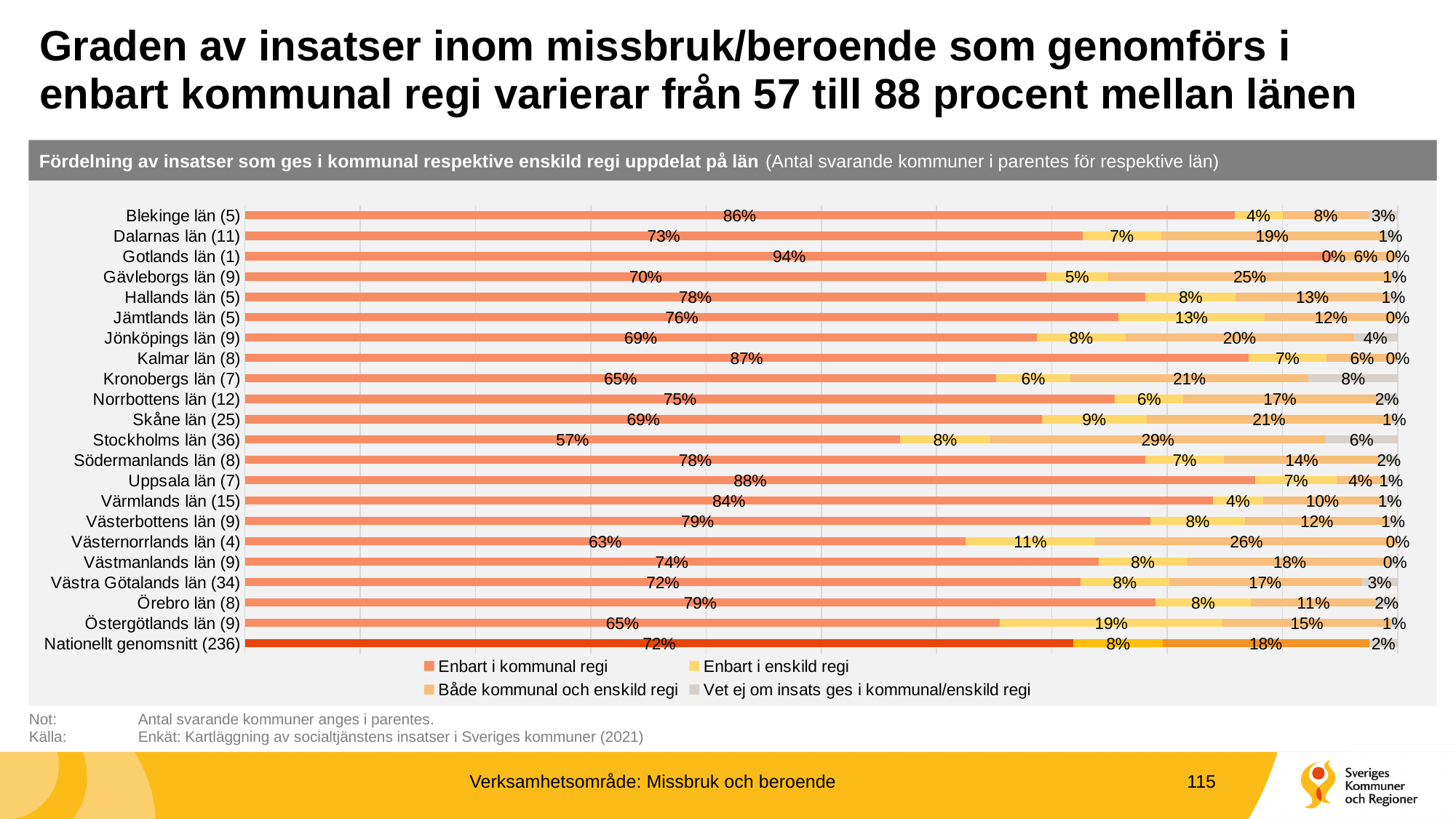
Which category has the highest value for "Enbart i kommunal regi"? Gotlands län (1) Which category has the lowest value for "Enbart i kommunal regi"? Stockholms län (36) Which series is shown in yellow in the legend? Enbart i enskild regi What is the value of "Både kommunal och enskild regi" for Gävleborgs län (9)? 25% What kind of chart is shown on the slide? Stacked bar chart What is the value of "Enbart i kommunal regi" for Stockholms län (36)? 57% What is the difference between the "Enbart i kommunal regi" values for Blekinge län (5) and Dalarnas län (11)? 13 percentage points What is the value of "Vet ej om insats ges i kommunal/enskild regi" for Kronobergs län (7)? 8% How many categories (bars) are shown in the chart? 22 How many series does the legend list? 4 Which has the larger "Enbart i enskild regi" value, Östergötlands län (9) or Jämtlands län (5)? Östergötlands län (9) What is the value of "Enbart i kommunal regi" for Nationellt genomsnitt (236)? 72%